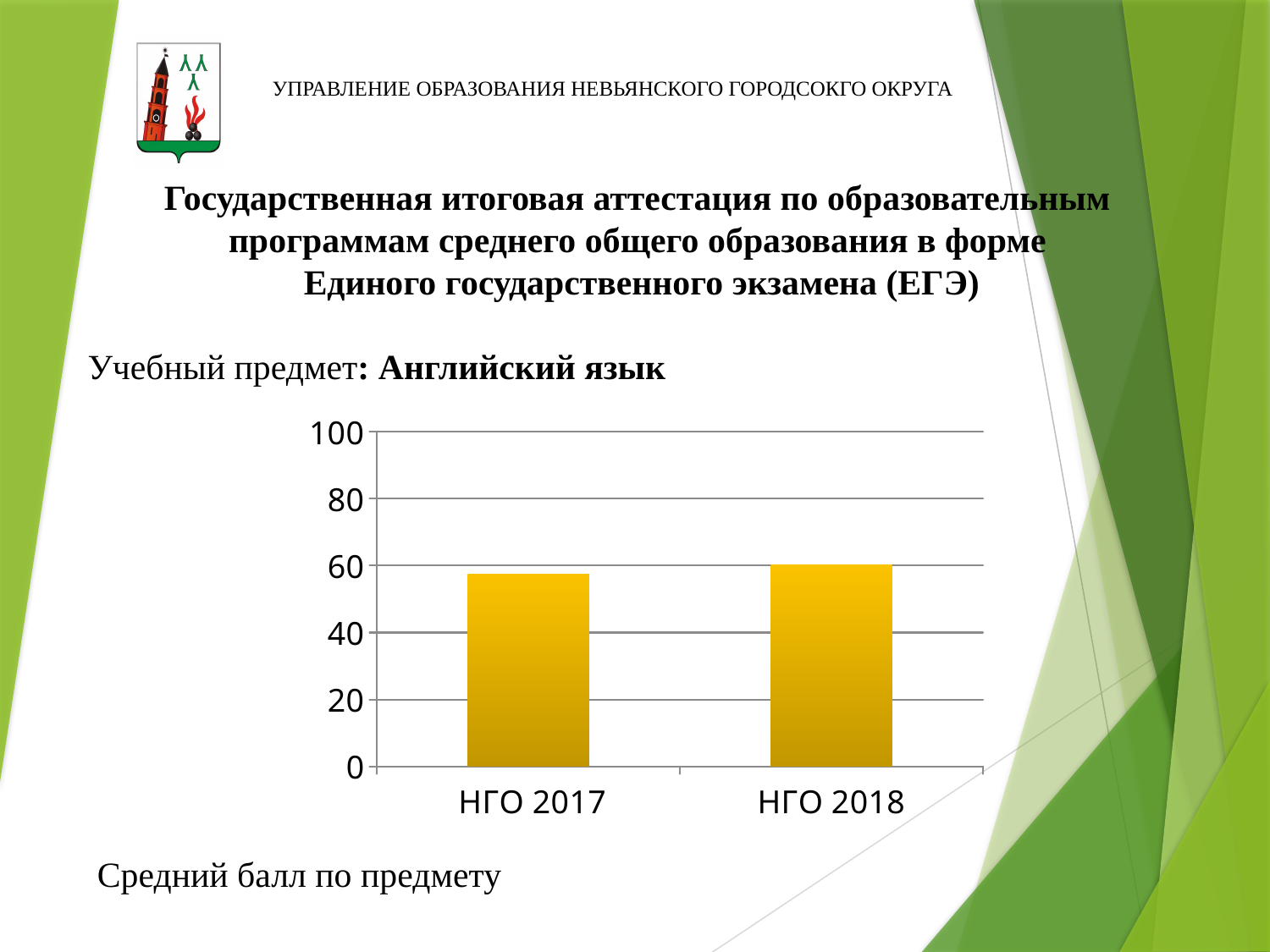
Is the value for НГО 2017 greater or less than 40? greater Is the value for НГО 2018 greater or less than 40? greater Which category has the lowest value in the chart? НГО 2017 What kind of chart is shown on the slide? bar chart Is the value for НГО 2018 greater or less than 80? less Which category has the highest value in the chart? НГО 2018 Which category has the higher bar, НГО 2017 or НГО 2018? НГО 2018 How many categories are shown on the x axis of the chart? 2 What is the maximum value shown on the vertical axis of the chart? 100 Do the values rise or fall from НГО 2017 to НГО 2018? rise Which school subject does the chart on the slide refer to? Английский язык